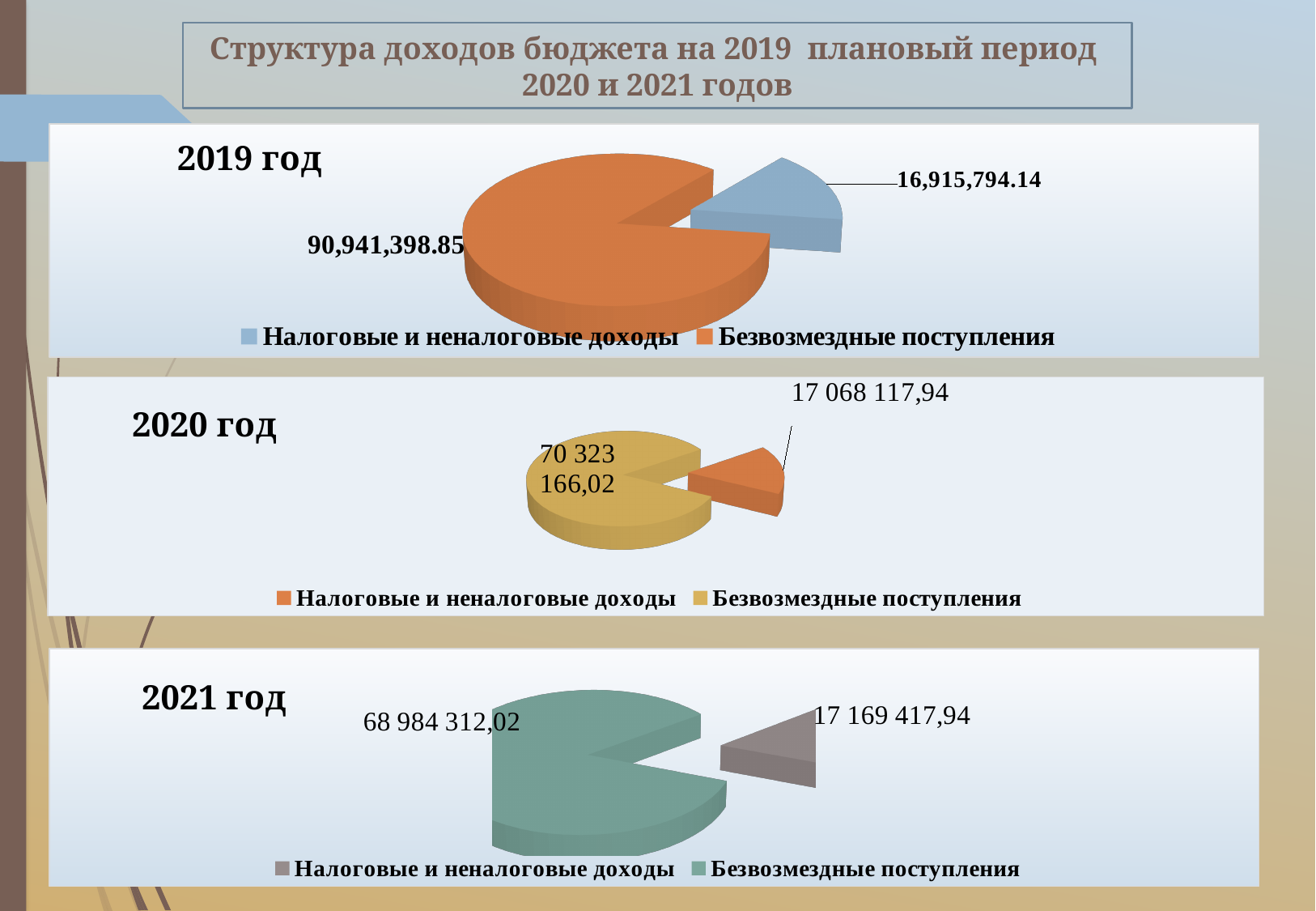
What kind of chart is used for the 2019 год data? Pie chart In the 2019 год chart, what is the value for Налоговые и неналоговые доходы? 16,915,794.14 How many categories does the legend of the 2021 год chart list? 2 In the 2021 год chart, what is the value for Безвозмездные поступления? 68 984 312,02 How many pie charts are shown on the slide? 3 In the 2021 год chart, what is the value for Налоговые и неналоговые доходы? 17 169 417,94 In the 2019 год chart, what is the difference between Безвозмездные поступления and Налоговые и неналоговые доходы? 74,025,604.71 In the 2020 год chart, which category has the smallest slice? Налоговые и неналоговые доходы In the 2021 год chart, which category has the largest slice? Безвозмездные поступления In the 2020 год chart, what is the value for Безвозмездные поступления? 70 323 166,02 In the 2019 год chart, what is the value for Безвозмездные поступления? 90,941,398.85 In the 2020 год chart, what is the value for Налоговые и неналоговые доходы? 17 068 117,94